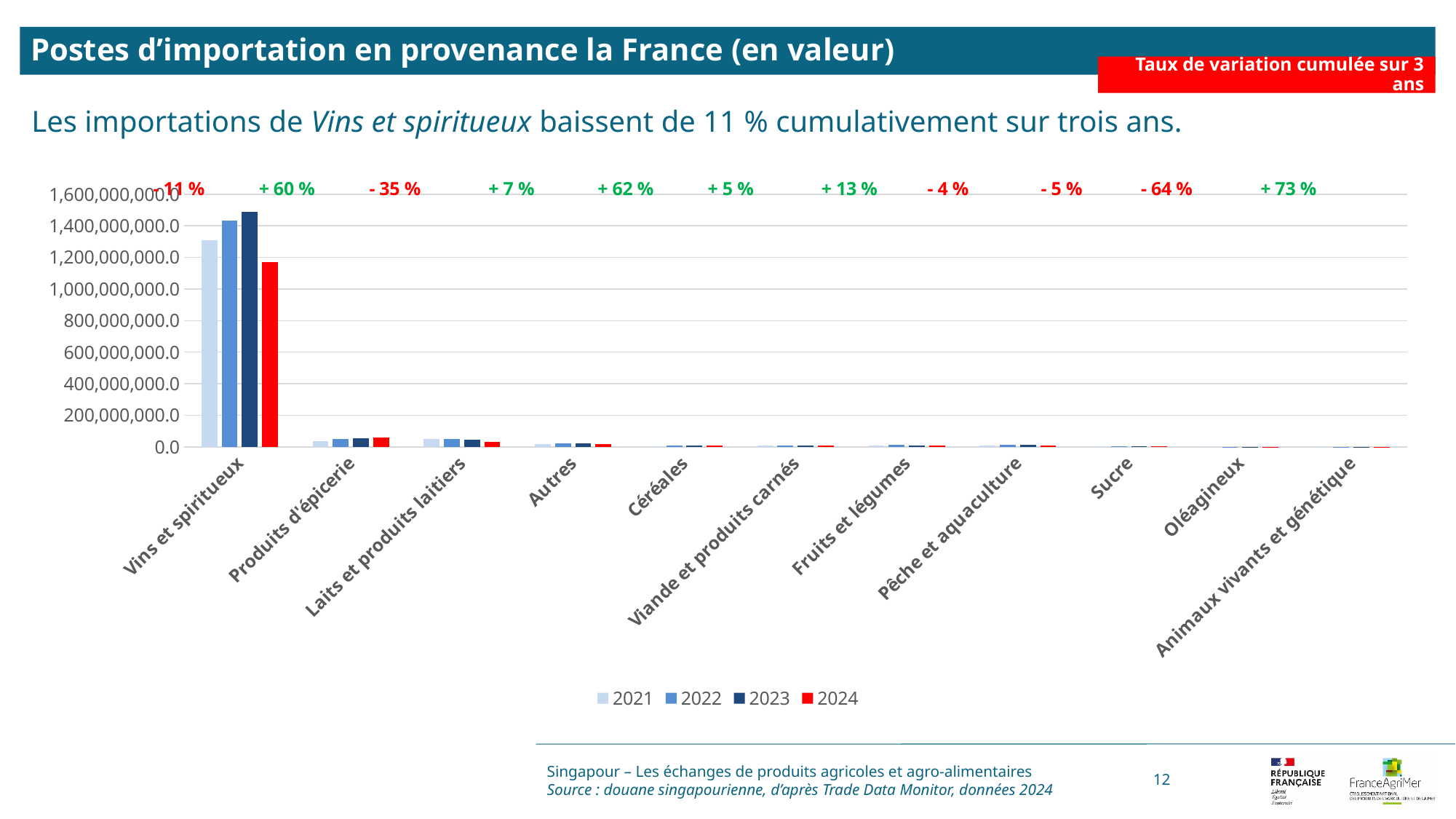
How many series does the chart legend list? 4 What kind of chart is shown on the slide? bar chart How many product categories are shown on the x axis of the chart? 11 Is the 2023 value for Vins et spiritueux greater or less than 1,400,000,000.0? greater What is the cumulative 3-year variation rate printed above Vins et spiritueux? - 11 % Which colour represents the 2024 series in the chart legend? red Which category shows the highest cumulative 3-year variation rate? Animaux vivants et génétique What is the cumulative 3-year variation rate printed above Produits d'épicerie? + 60 % What is the cumulative 3-year variation rate printed above Oléagineux? - 64 % For Vins et spiritueux, which is larger: the 2023 value or the 2024 value? 2023 Which category shows the lowest cumulative 3-year variation rate? Oléagineux Which category has the highest import values in the chart? Vins et spiritueux